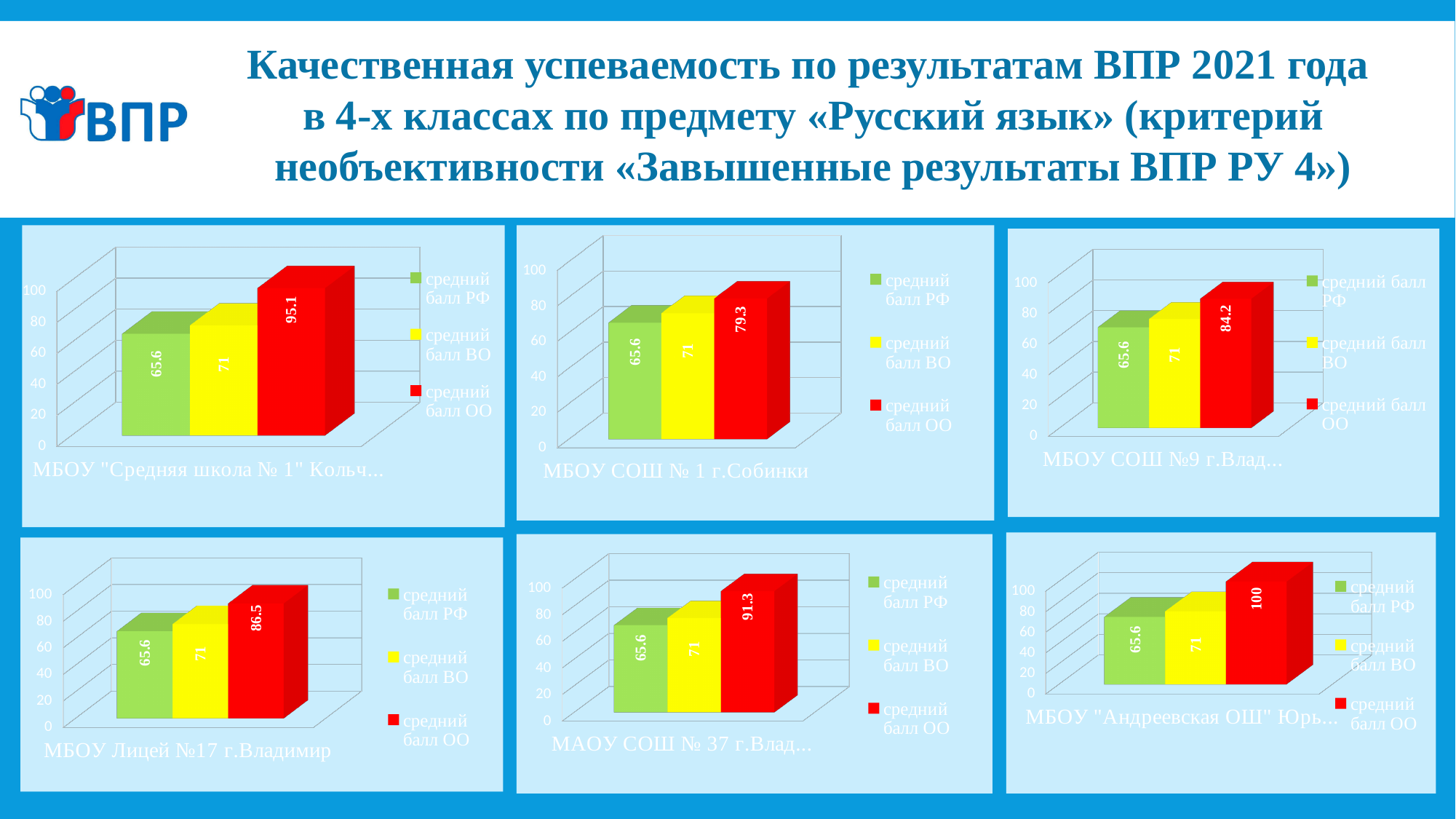
In the chart for МБОУ СОШ № 1 г.Собинки (top middle), what is the value for средний балл ОО? 79.3 In the top-left chart (МБОУ "Средняя школа № 1" Кольч...), what is the value for средний балл РФ? 65.6 How many charts are shown on the slide? 6 How many series does the legend list in the bottom-left chart (МБОУ Лицей №17 г.Владимир)? 3 In the top-right chart (МБОУ СОШ №9 г.Влад...), which series has the highest value? средний балл ОО In the bottom-middle chart (МАОУ СОШ № 37 г.Влад...), what is the difference between средний балл ОО and средний балл ВО? 20.3 Which is larger: средний балл ОО in the top-middle chart (МБОУ СОШ № 1 г.Собинки) or средний балл ОО in the top-right chart (МБОУ СОШ №9 г.Влад...)? МБОУ СОШ №9 г.Влад... In the bottom-middle chart (МАОУ СОШ № 37 г.Влад...), which series has the lowest value? средний балл РФ In the top-left chart (МБОУ "Средняя школа № 1" Кольч...), what is the difference between средний балл ОО and средний балл РФ? 29.5 In the bottom-right chart (МБОУ "Андреевская ОШ" Юрь...), what is the value for средний балл ОО? 100 What kind of chart is the top-middle chart (МБОУ СОШ № 1 г.Собинки)? bar chart In the chart for МБОУ Лицей №17 г.Владимир (bottom left), what is the value for средний балл ОО? 86.5